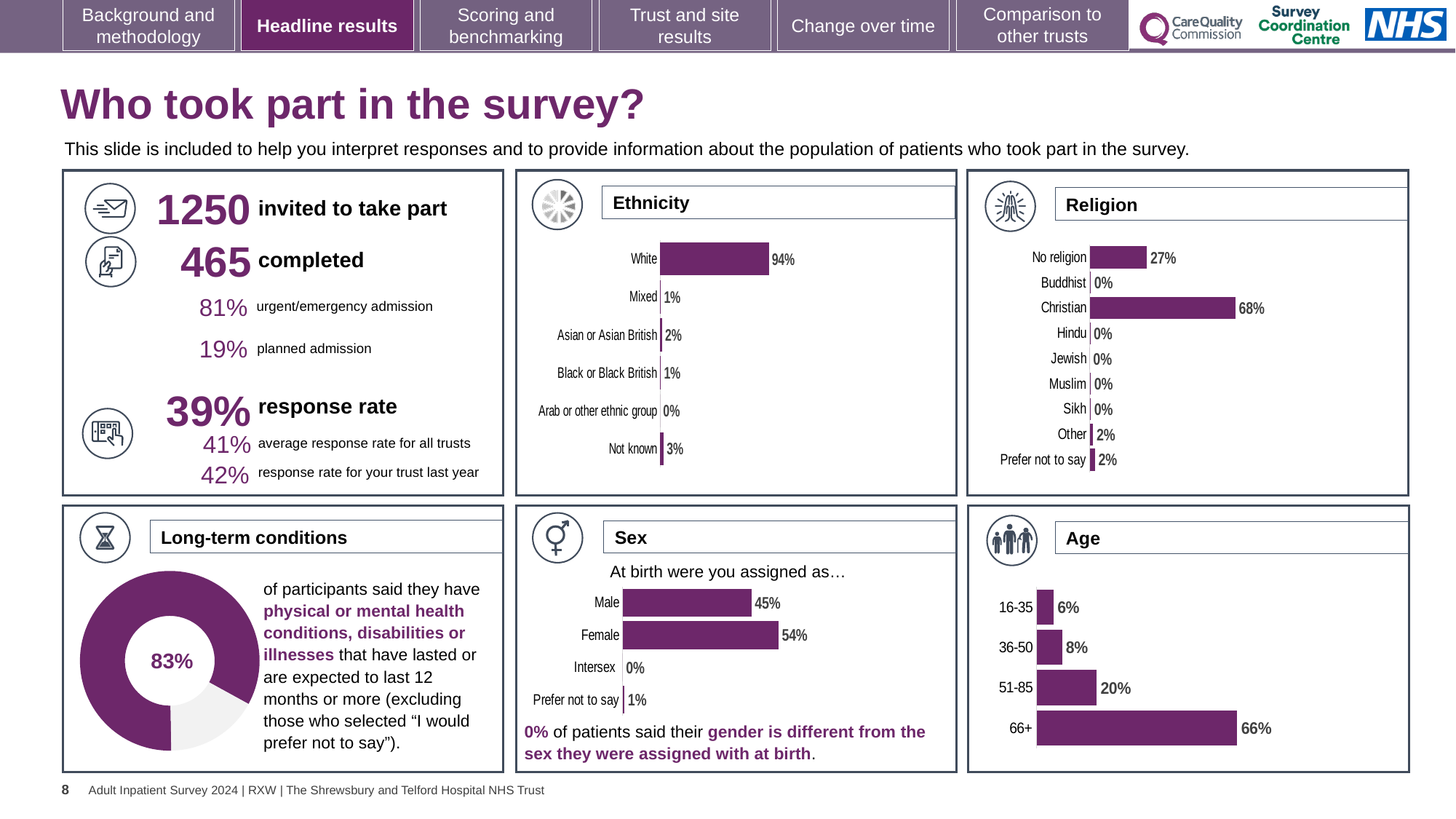
In the Sex chart, what percentage of respondents were Female? 54% In the Religion chart, what is the difference between the Christian and No religion values? 41% In the Ethnicity chart, which category has the highest value? White In the Age chart, which age group has the lowest value? 16-35 In the Age chart, do the values rise or fall as the age groups get older? rise In the Religion chart, what percentage of respondents were Christian? 68% In the Sex chart, which is larger, Male or Female? Female In the Age chart, what percentage of respondents were aged 66+? 66% In the Ethnicity chart, how many categories are shown? 6 In the Ethnicity chart, what percentage of respondents were White? 94% What kind of chart is used in the Long-term conditions panel? doughnut chart In the Religion chart, how many categories are shown? 9